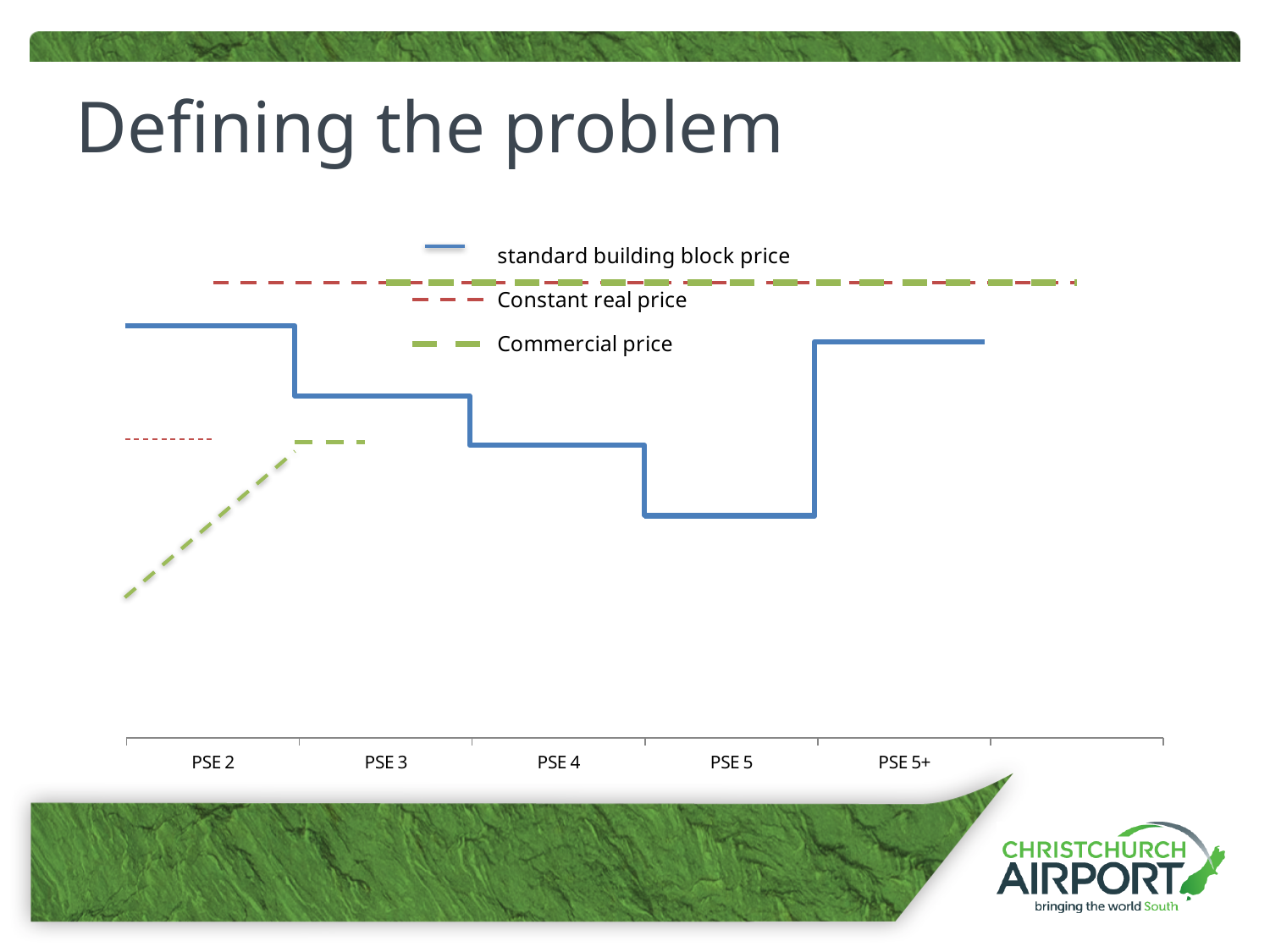
In which period is the standard building block price at its lowest? PSE 5 How many series does the legend list? 3 How many categories are labelled on the x axis? 5 Does the standard building block price rise or fall from PSE 5 to PSE 5+? rise Is the standard building block price higher in PSE 3 or in PSE 4? PSE 3 What is the first category on the x axis? PSE 2 Which series is drawn as a green dashed line? Commercial price Which series stays flat across all periods at the top of the chart? Constant real price Does the standard building block price rise or fall from PSE 2 to PSE 5? fall What kind of chart is shown on the slide? line chart Which series is drawn as a solid blue line? standard building block price Is the standard building block price higher in PSE 2 or in PSE 5? PSE 2